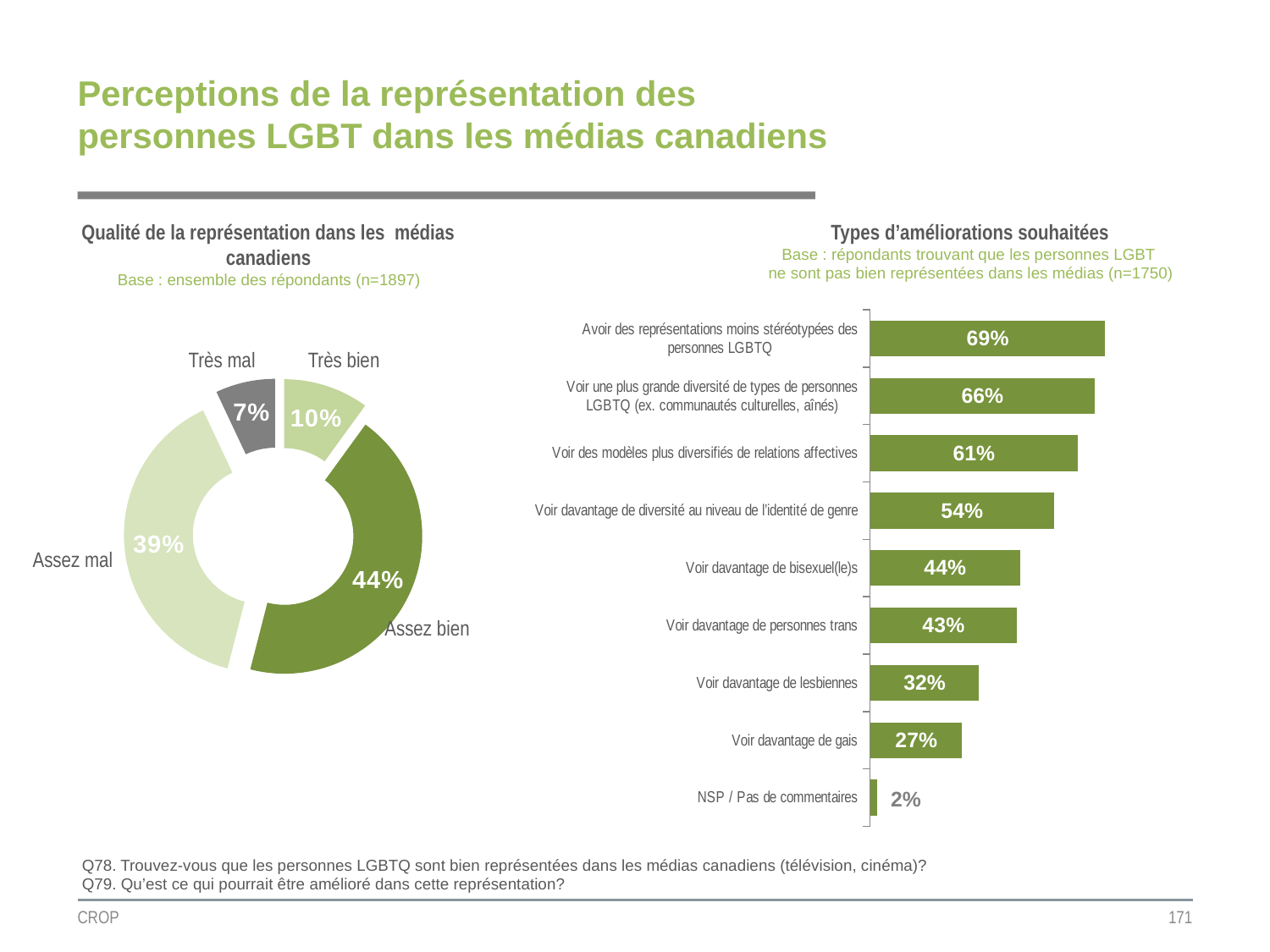
What kind of chart is the 'Qualité de la représentation dans les médias canadiens' chart? Pie (donut) chart In the 'Types d'améliorations souhaitées' chart, which category has the highest value? Avoir des représentations moins stéréotypées des personnes LGBTQ In the 'Types d'améliorations souhaitées' chart, how many categories are shown? 9 In the 'Qualité de la représentation dans les médias canadiens' chart, what is the difference between the 'Assez bien' and 'Assez mal' shares? 5% In the 'Types d'améliorations souhaitées' chart, what is the difference between 'Voir des modèles plus diversifiés de relations affectives' and 'Voir davantage de gais'? 34% In the 'Qualité de la représentation dans les médias canadiens' chart, what share of respondents answered 'Très mal'? 7% In the 'Qualité de la représentation dans les médias canadiens' chart, which category has the largest share? Assez bien In the 'Qualité de la représentation dans les médias canadiens' chart, what share of respondents answered 'Assez bien'? 44% In the 'Types d'améliorations souhaitées' chart, what is the value for 'Voir davantage de lesbiennes'? 32% In the 'Types d'améliorations souhaitées' chart, what is the value for 'Voir davantage de personnes trans'? 43% What kind of chart is the 'Types d'améliorations souhaitées' chart? Bar chart In the 'Qualité de la représentation dans les médias canadiens' chart, which category has the smallest share? Très mal